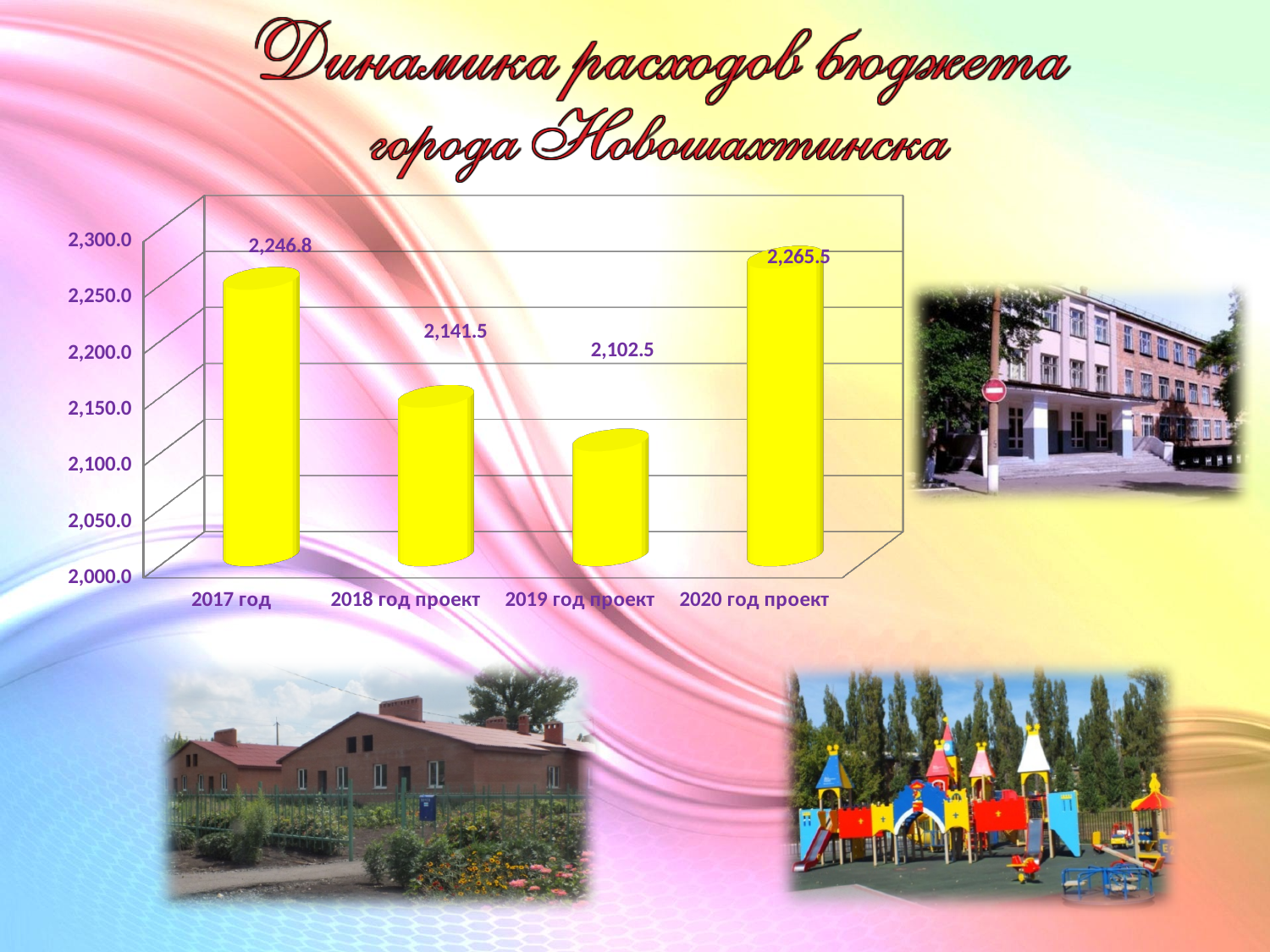
What is the title of the chart? Динамика расходов бюджета города Новошахтинска Which category has the highest value? 2020 год проект Which is larger, the value for 2017 год or the value for 2020 год проект? 2020 год проект What is the value for 2019 год проект? 2,102.5 What is the value for 2017 год? 2,246.8 How many categories are shown on the x axis? 4 What kind of chart is shown on the slide? bar chart What is the value for 2020 год проект? 2,265.5 What is the difference between the values for 2020 год проект and 2019 год проект? 163.0 What is the difference between the values for 2017 год and 2018 год проект? 105.3 Which category has the lowest value? 2019 год проект What is the value for 2018 год проект? 2,141.5